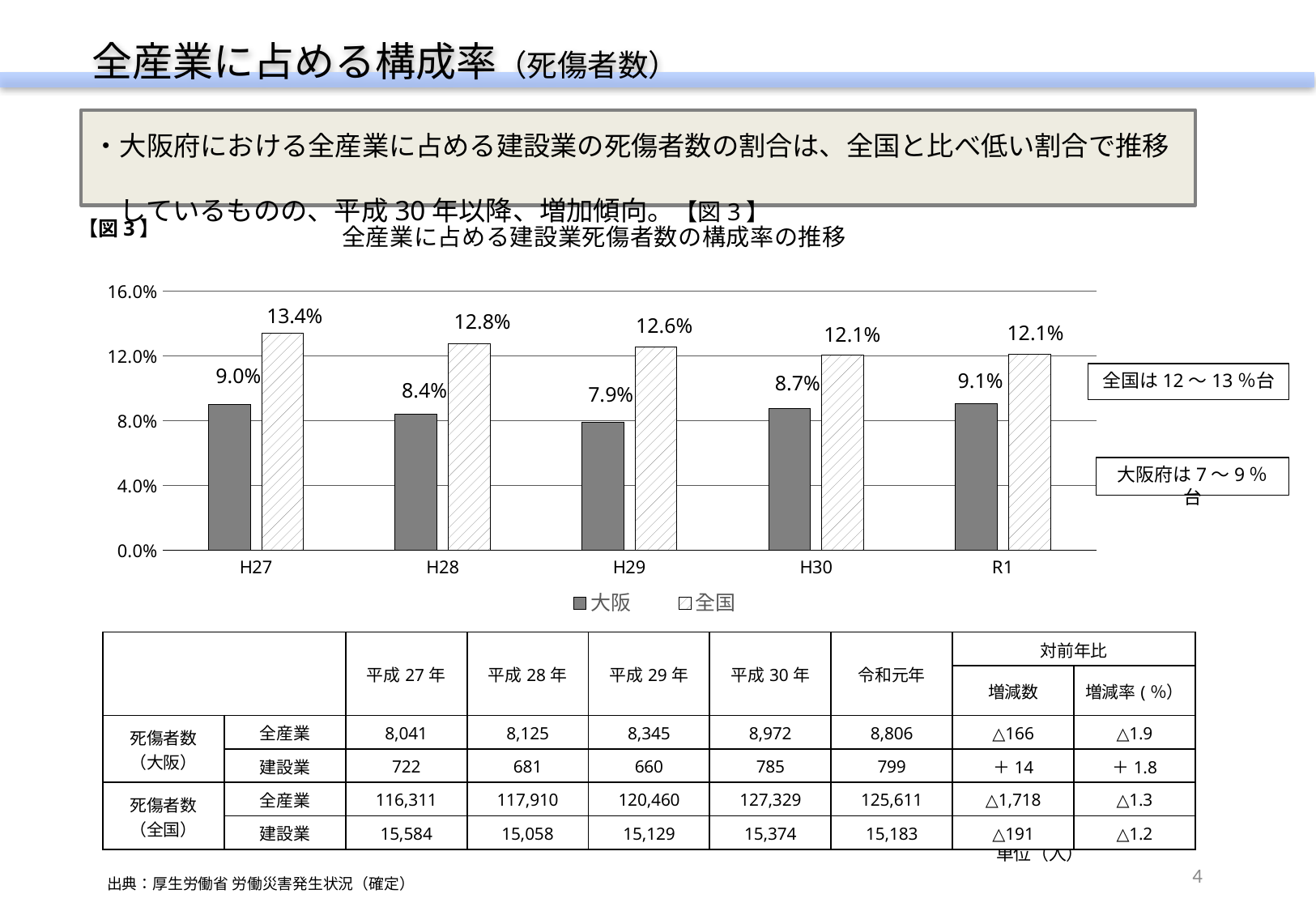
In which year is the 全国 value highest? H27 What is the difference between the 全国 and 大阪 values in H28? 4.4% Which is larger in H30, the value for 大阪 or for 全国? 全国 What is the value for 全国 in H29? 12.6% Does the 全国 value rise or fall from H27 to H30? fall Is the value for 全国 in R1 greater or less than 8.0%? greater How many years are shown on the x axis? 5 In which year is the 大阪 value lowest? H29 What kind of chart is shown? bar chart What is the value for 大阪 in R1? 9.1% What is the value for 大阪 in H27? 9.0% How many series does the legend list? 2